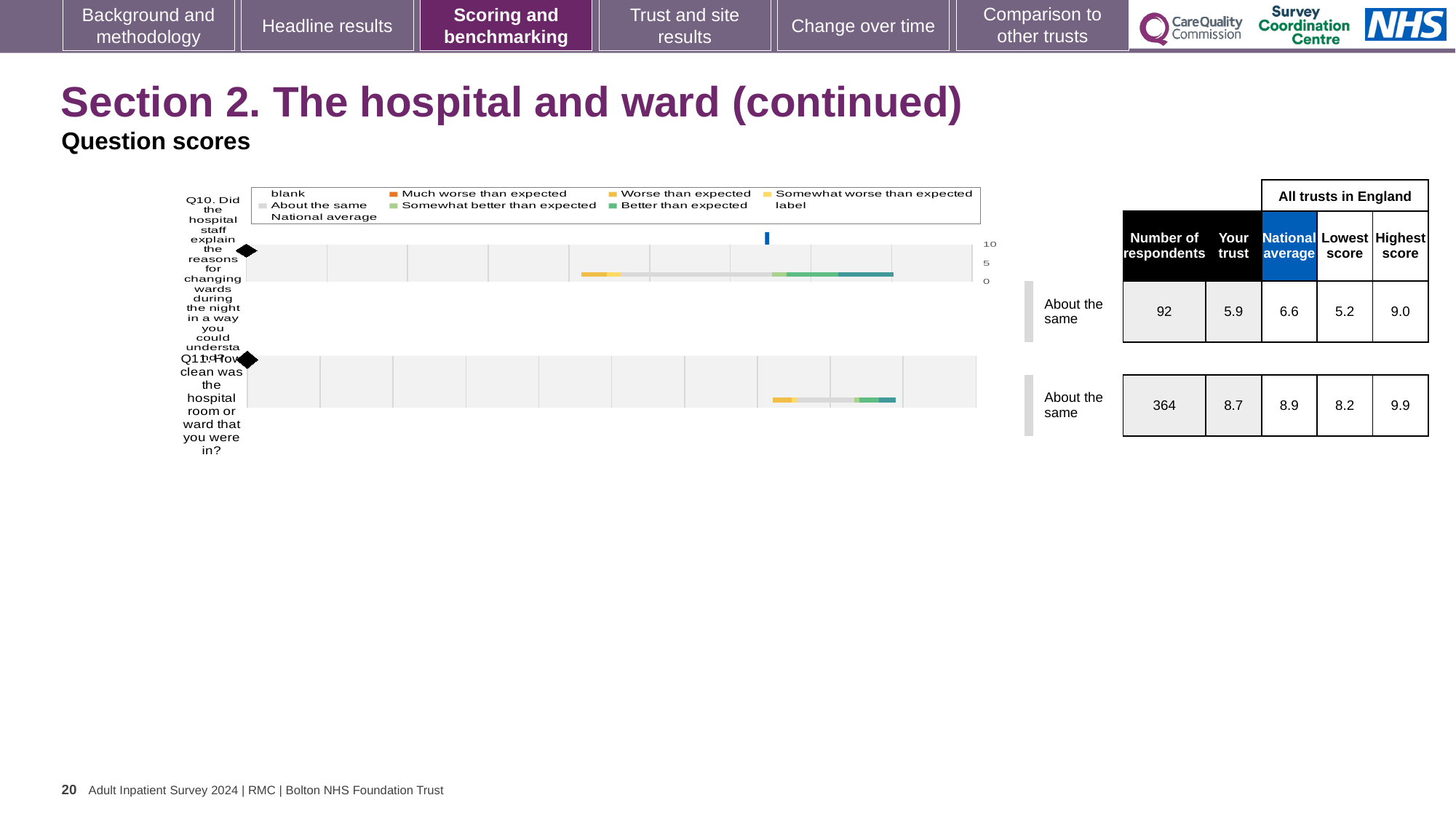
What is the 'Your trust' score for Q11 (How clean was the hospital room or ward that you were in?)? 8.7 What benchmark category is shown for both Q10 and Q11? About the same What is the difference between the national average and the trust's score for Q10? 0.7 How many survey questions are plotted on the slide? 2 What is the difference between the highest and lowest scores for Q11? 1.7 How many respondents answered Q11? 364 What is the highest score across all trusts in England for Q10? 9.0 For Q10, which is larger: the trust's score or the national average? National average Which question had more respondents, Q10 or Q11? Q11 What is the national average score for Q10 (Did the hospital staff explain the reasons for changing wards during the night)? 6.6 What kind of chart is used to show the question scores for Q10 and Q11? Bar chart What is the lowest score across all trusts in England for Q11? 8.2